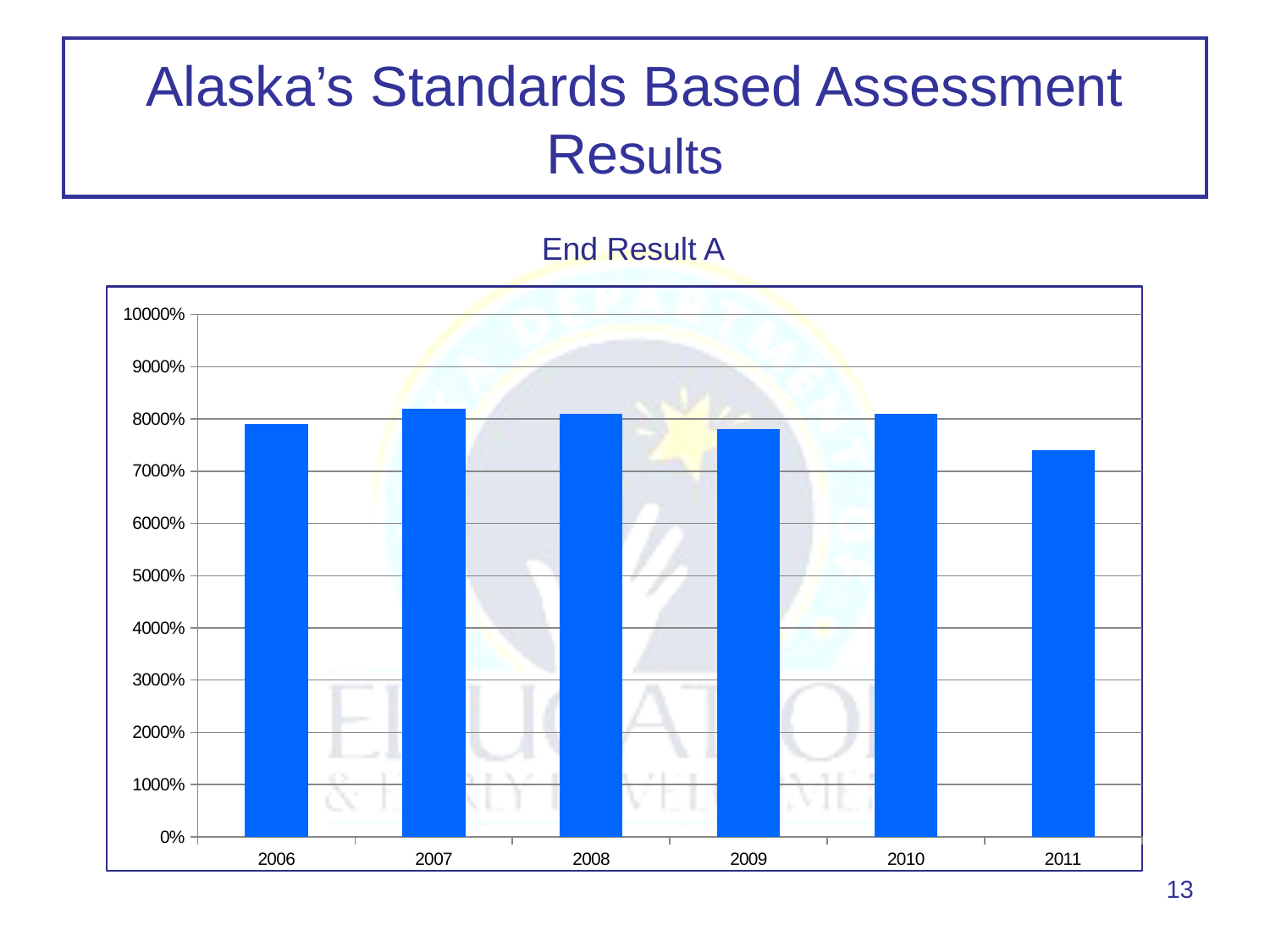
Which year has the lowest bar in the chart? 2011 Is the value for 2009 greater or less than 8000%? less Which is larger, the value for 2007 or the value for 2009? 2007 Is the value for 2007 greater or less than 8000%? greater What is the title shown above the chart? End Result A Which is larger, the value for 2006 or the value for 2011? 2006 How many years are shown on the x axis of the chart? 6 Is the value for 2006 greater or less than 7000%? greater Do the values rise or fall from 2010 to 2011? fall What kind of chart is shown on the slide? bar chart Which year has the highest bar in the chart? 2007